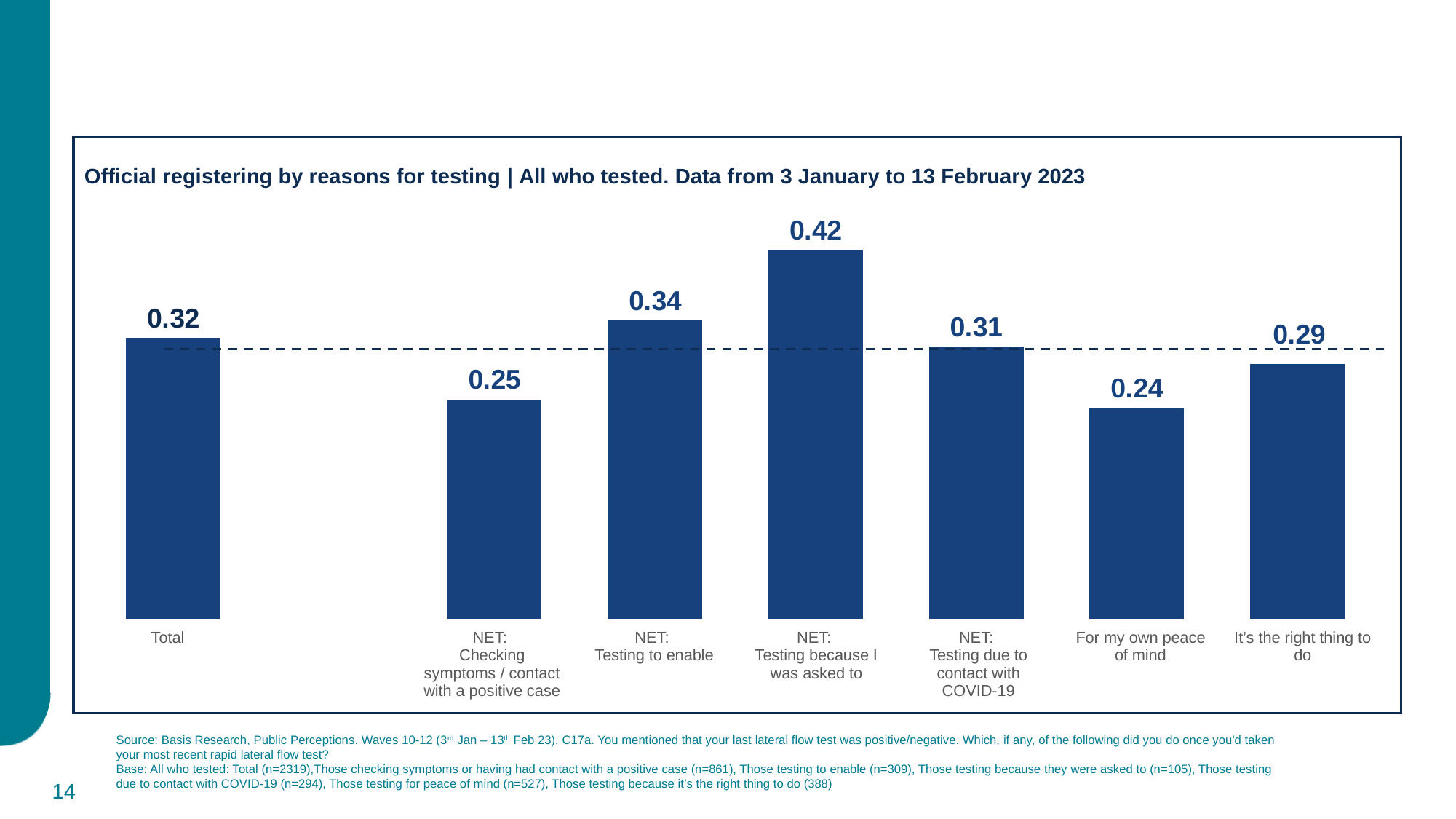
What is the difference between NET: Testing because I was asked to and NET: Checking symptoms / contact with a positive case? 0.17 What is the difference between NET: Testing to enable and Total? 0.02 What is the value for NET: Testing because I was asked to? 0.42 What is the value for Total? 0.32 How many categories are shown on the chart? 7 Which category has the lowest value? For my own peace of mind What kind of chart is this? Bar chart Which category has the highest value? NET: Testing because I was asked to Which is larger, NET: Testing due to contact with COVID-19 or It's the right thing to do? NET: Testing due to contact with COVID-19 What is the title of the chart? Official registering by reasons for testing | All who tested. Data from 3 January to 13 February 2023 What is the value for For my own peace of mind? 0.24 What is the value for It's the right thing to do? 0.29